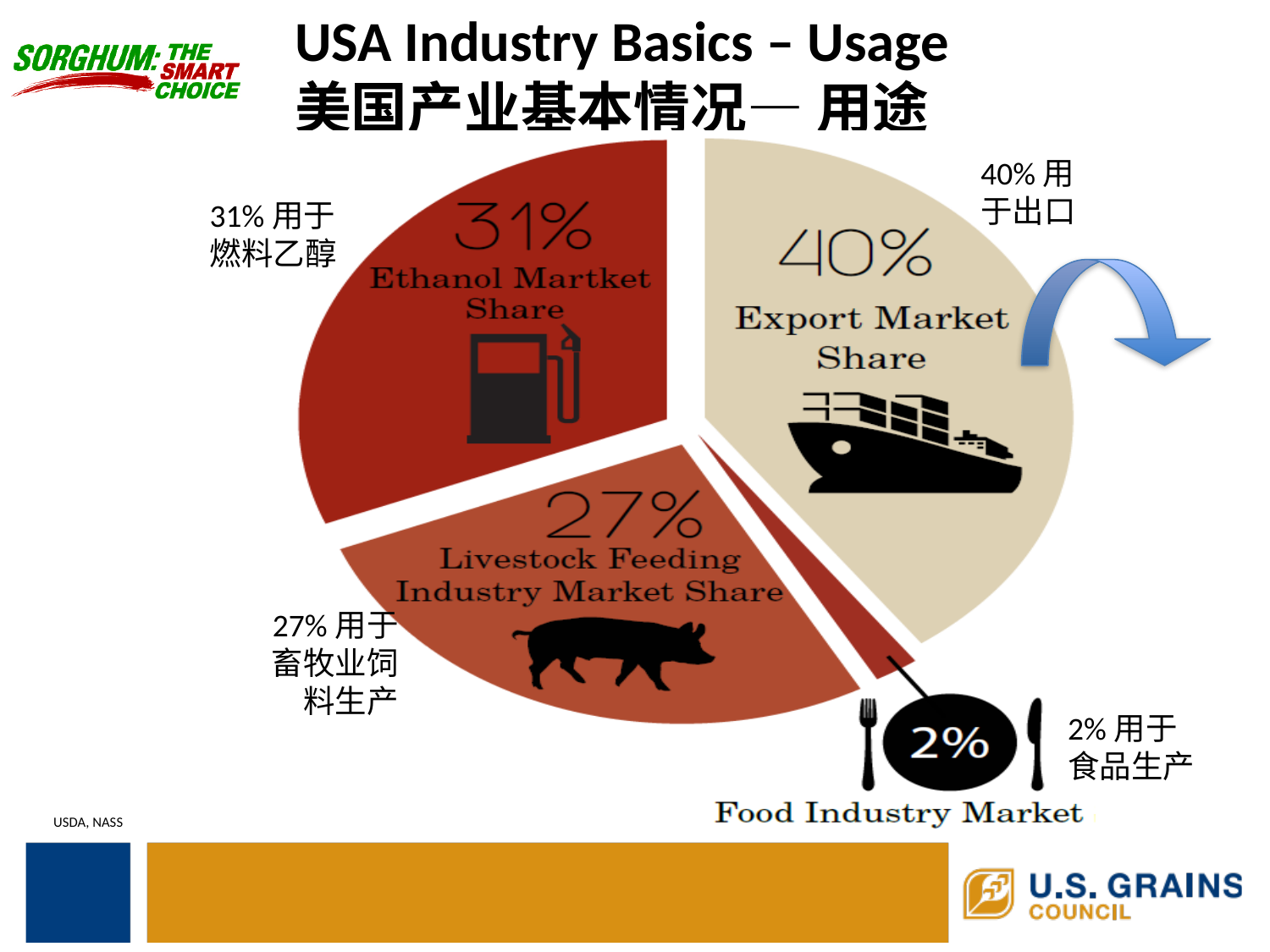
What is the source cited for the chart data? USDA, NASS What is the difference between the Livestock Feeding Industry Market Share and the Food Industry Market share? 25% What kind of chart is shown on the slide? pie chart How many segments does the pie chart have? 4 What is the Export Market Share percentage? 40% Which segment has the smallest share of the pie? Food Industry Market What is the Livestock Feeding Industry Market Share percentage? 27% What is the difference between the Export Market Share and the Ethanol Market Share? 9% What is the Ethanol Market Share percentage? 31% Which segment has the largest share of the pie? Export Market Share What is the Food Industry Market share percentage? 2% Which is larger, the Ethanol Market Share or the Livestock Feeding Industry Market Share? Ethanol Market Share